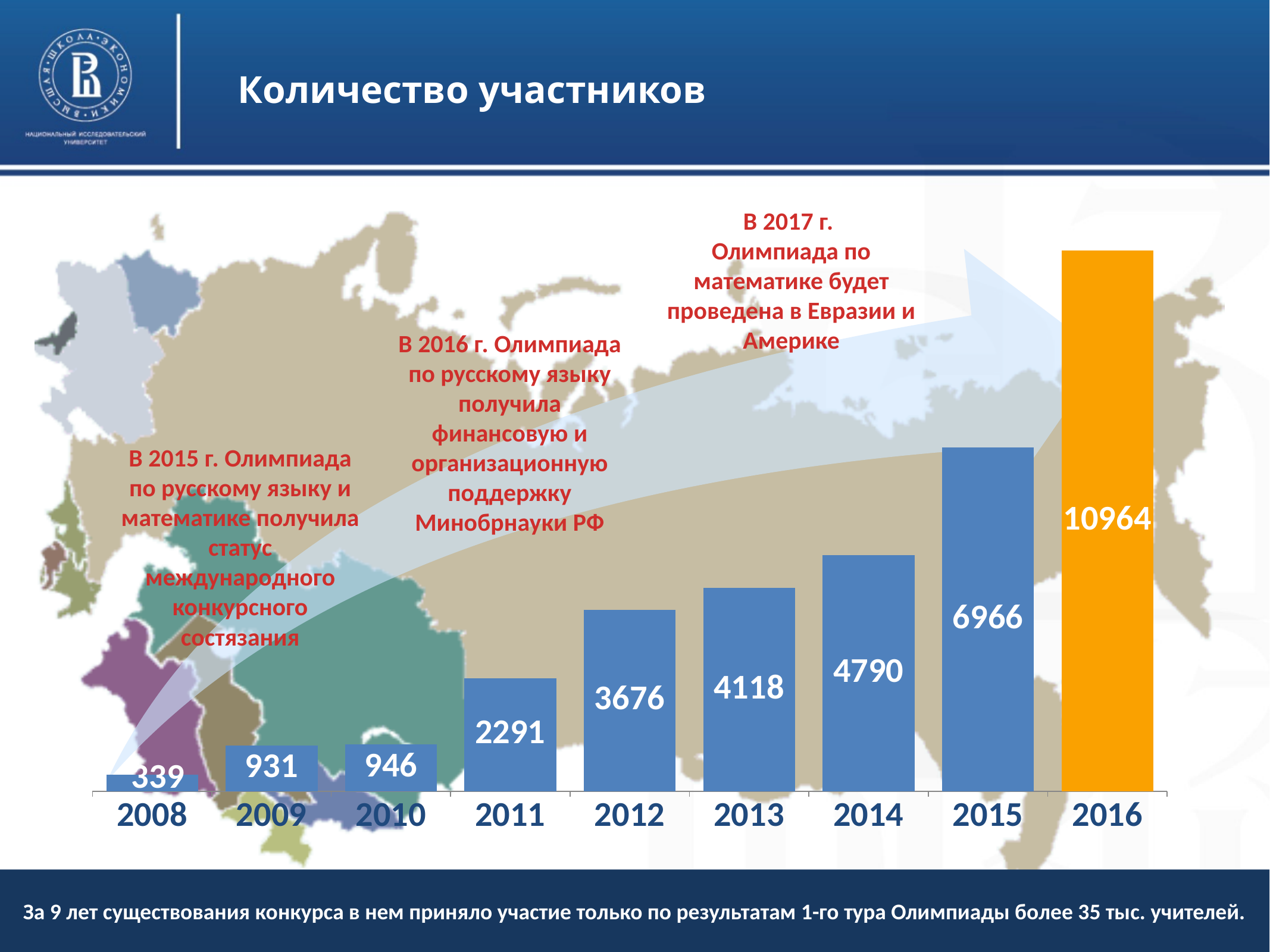
What is the difference between the number of participants in 2016 and in 2015? 3998 What is the difference between the number of participants in 2010 and in 2009? 15 What is the number of participants in 2008? 339 Which year has the lowest number of participants? 2008 Do the number of participants rise or fall from 2008 to 2016? rise What is the number of participants in 2015? 6966 What kind of chart is shown on the slide? bar chart What is the number of participants in 2012? 3676 How many years are shown on the x axis of the chart? 9 Which bar is coloured orange instead of blue? 2016 Which year has more participants, 2011 or 2013? 2013 Which year has the highest number of participants? 2016